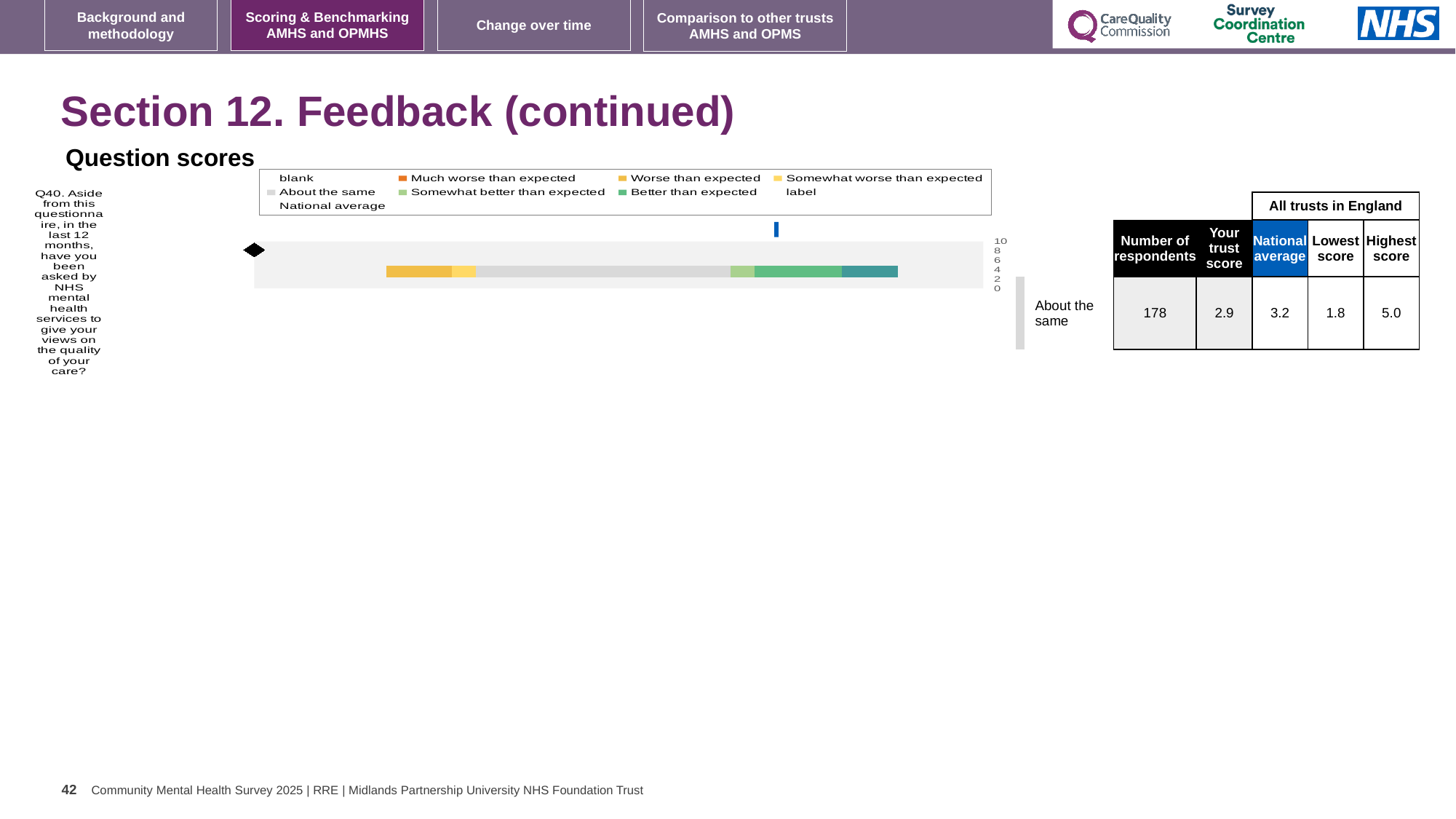
What colour does the legend use for 'Much worse than expected'? orange In the table beside the chart, what is the lowest score among all trusts in England for Q40? 1.8 In the table beside the chart, what is the number of respondents for Q40? 178 In the table beside the chart, what is the national average for Q40? 3.2 In the table beside the chart, what is the highest score among all trusts in England for Q40? 5.0 In the table beside the chart, what is the trust score for Q40? 2.9 What kind of chart is shown on the slide? bar chart In the table beside the chart, what is the difference between the highest score and the lowest score for Q40? 3.2 How many question categories are plotted in the chart? 1 Which question number is plotted in the chart? Q40 In the table beside the chart, which is larger for Q40: the trust score or the national average? national average According to the label beside the chart, how is the trust's result for Q40 rated? About the same